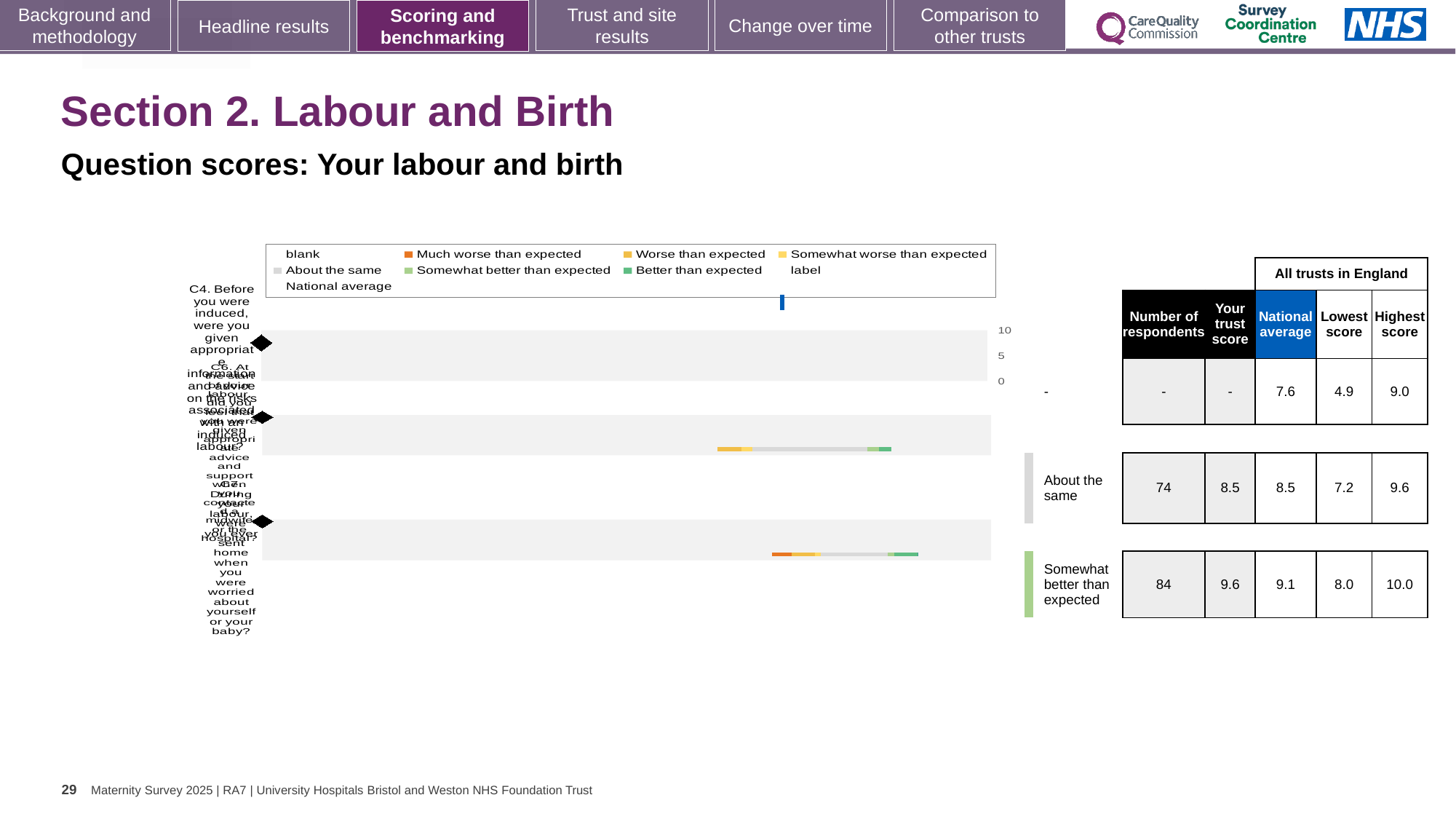
In the table beside the chart, what is the difference between the trust score and the national average for the 'Somewhat better than expected' row? 0.5 How many entries does the chart legend list? 9 In the table beside the chart, what is the highest score for the row labelled 'Somewhat better than expected'? 10.0 In the table beside the chart, for the 'Somewhat better than expected' row, which is larger: the trust score or the national average? trust score In the table beside the chart, what is the number of respondents for the row labelled 'Somewhat better than expected'? 84 In the table beside the chart, what is the difference between the highest and lowest score in the first row (national average 7.6)? 4.1 How many question rows does the table beside the chart contain? 3 What kind of chart is shown on the slide? bar chart In the table beside the chart, what is the lowest score in the first row (national average 7.6)? 4.9 What colour does the legend use for 'Much worse than expected'? orange What is the highest tick value shown on the chart's score axis? 10 In the table beside the chart, what is the trust score for the row labelled 'About the same'? 8.5